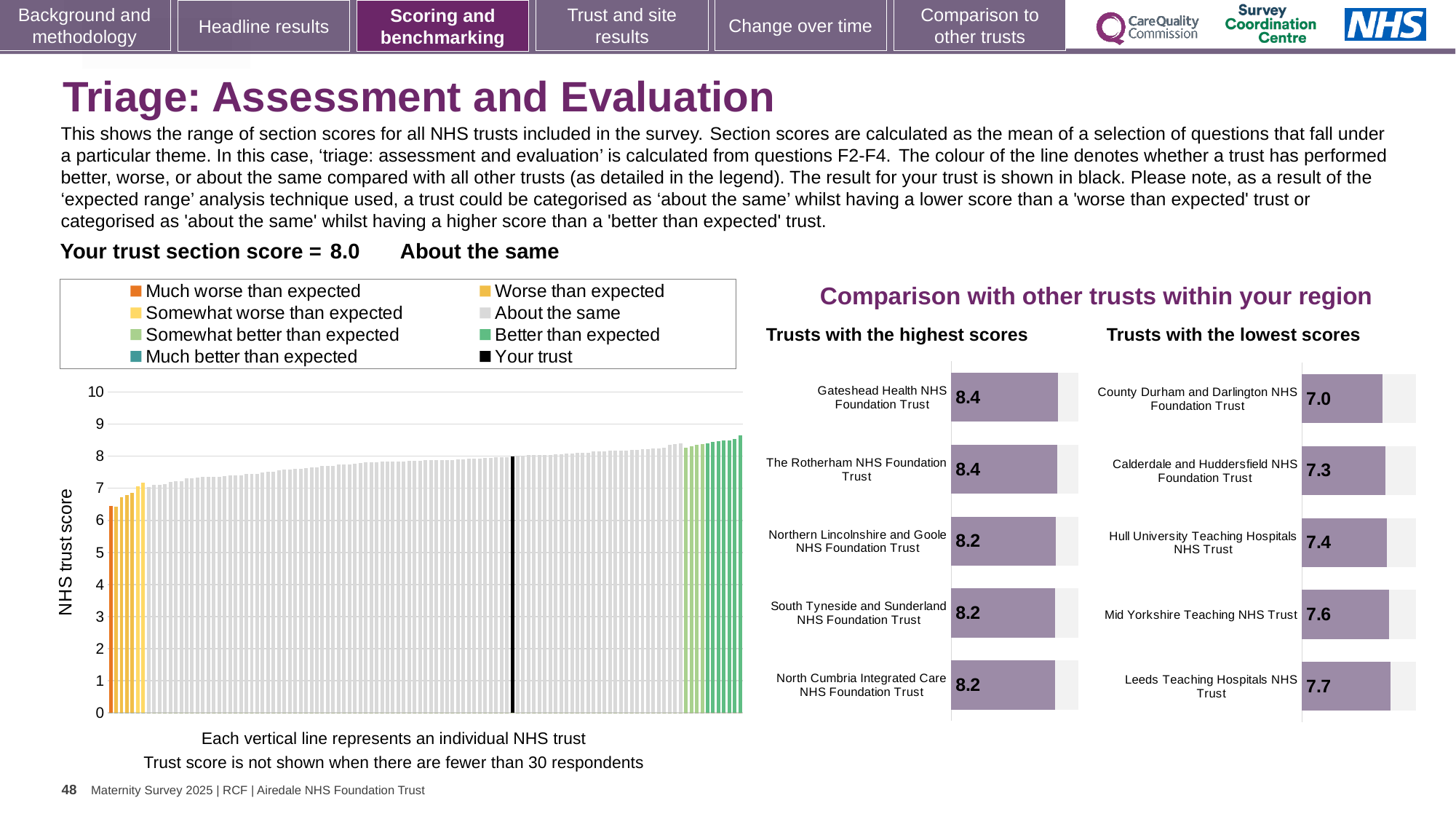
In the 'Trusts with the highest scores' chart, what is the score for Gateshead Health NHS Foundation Trust? 8.4 In the 'Trusts with the lowest scores' chart, which trust has the highest score? Leeds Teaching Hospitals NHS Trust In the NHS trust score chart on the left, do the trust scores rise or fall from left to right? Rise How many entries does the legend of the NHS trust score chart on the left list? 8 How many trusts are shown in the 'Trusts with the lowest scores' chart? 5 In the 'Trusts with the lowest scores' chart, what is the score for Hull University Teaching Hospitals NHS Trust? 7.4 What kind of chart is the 'Trusts with the highest scores' chart? Bar chart In the 'Trusts with the lowest scores' chart, which trust has the lowest score? County Durham and Darlington NHS Foundation Trust In the 'Trusts with the lowest scores' chart, what is the score for County Durham and Darlington NHS Foundation Trust? 7.0 In the 'Trusts with the lowest scores' chart, which has the higher score: Calderdale and Huddersfield NHS Foundation Trust or Mid Yorkshire Teaching NHS Trust? Mid Yorkshire Teaching NHS Trust In the 'Trusts with the highest scores' chart, what is the difference between the scores of Gateshead Health NHS Foundation Trust and North Cumbria Integrated Care NHS Foundation Trust? 0.2 In the 'Trusts with the lowest scores' chart, what is the difference between the scores of Leeds Teaching Hospitals NHS Trust and County Durham and Darlington NHS Foundation Trust? 0.7